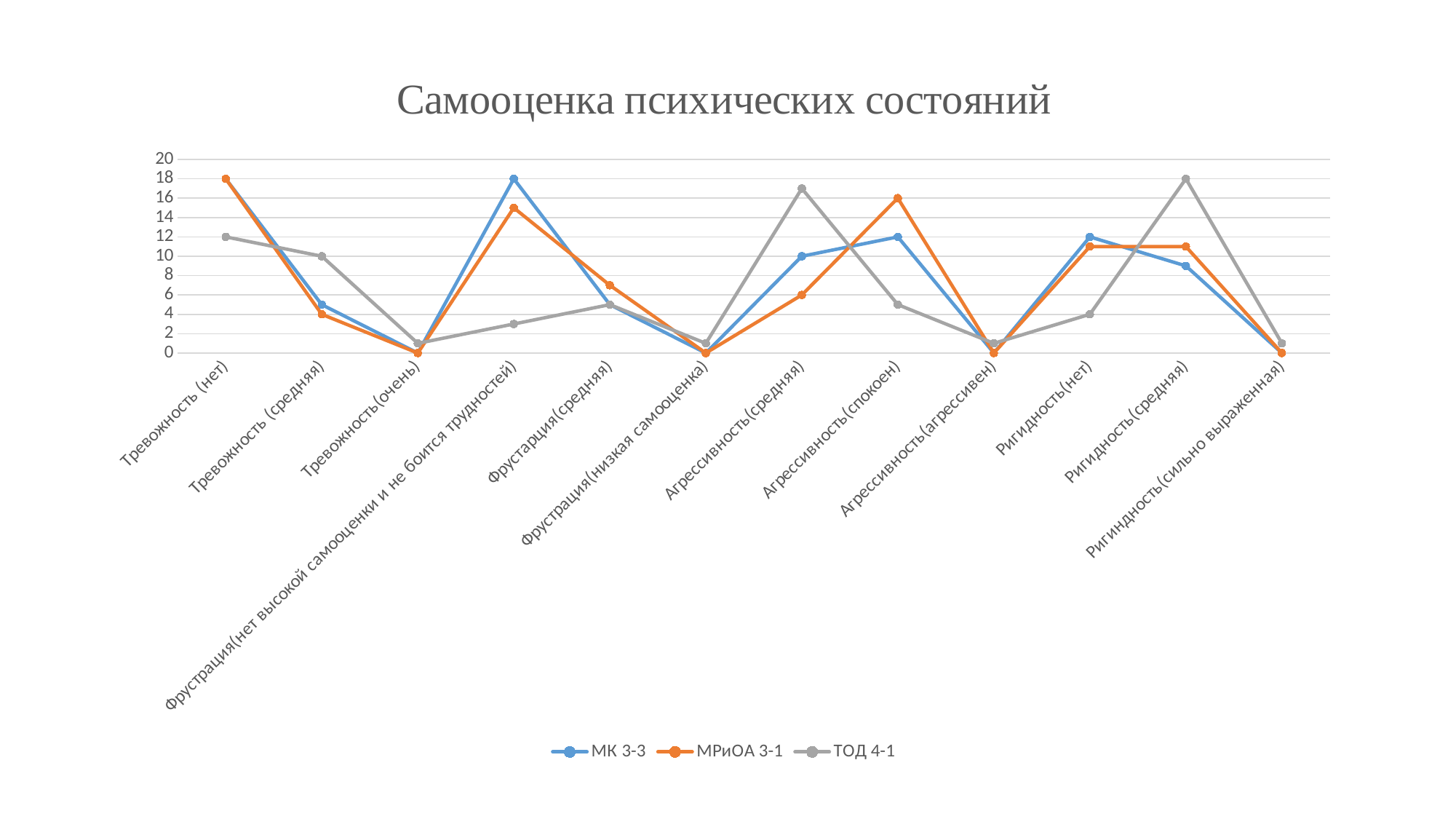
Which series has the highest value at Агрессивность (средняя)? ТОД 4-1 What is the title of the chart? Самооценка психических состояний How many series does the legend list? 3 Which series has the lowest value at Фрустрация(нет высокой самооценки и не боится трудностей)? ТОД 4-1 Is the value for МРиОА 3-1 at Фрустарция(средняя) greater or less than 4? greater What is the value for МРиОА 3-1 at Агрессивность (спокоен)? 16 What kind of chart is shown on the slide? line chart Which is larger at Ригидность (средняя): МК 3-3 or ТОД 4-1? ТОД 4-1 How many categories are shown on the x axis? 12 What is the value for ТОД 4-1 at Ригидность (средняя)? 18 What is the value for ТОД 4-1 at Тревожность (нет)? 12 What is the value for МК 3-3 at Тревожность (нет)? 18